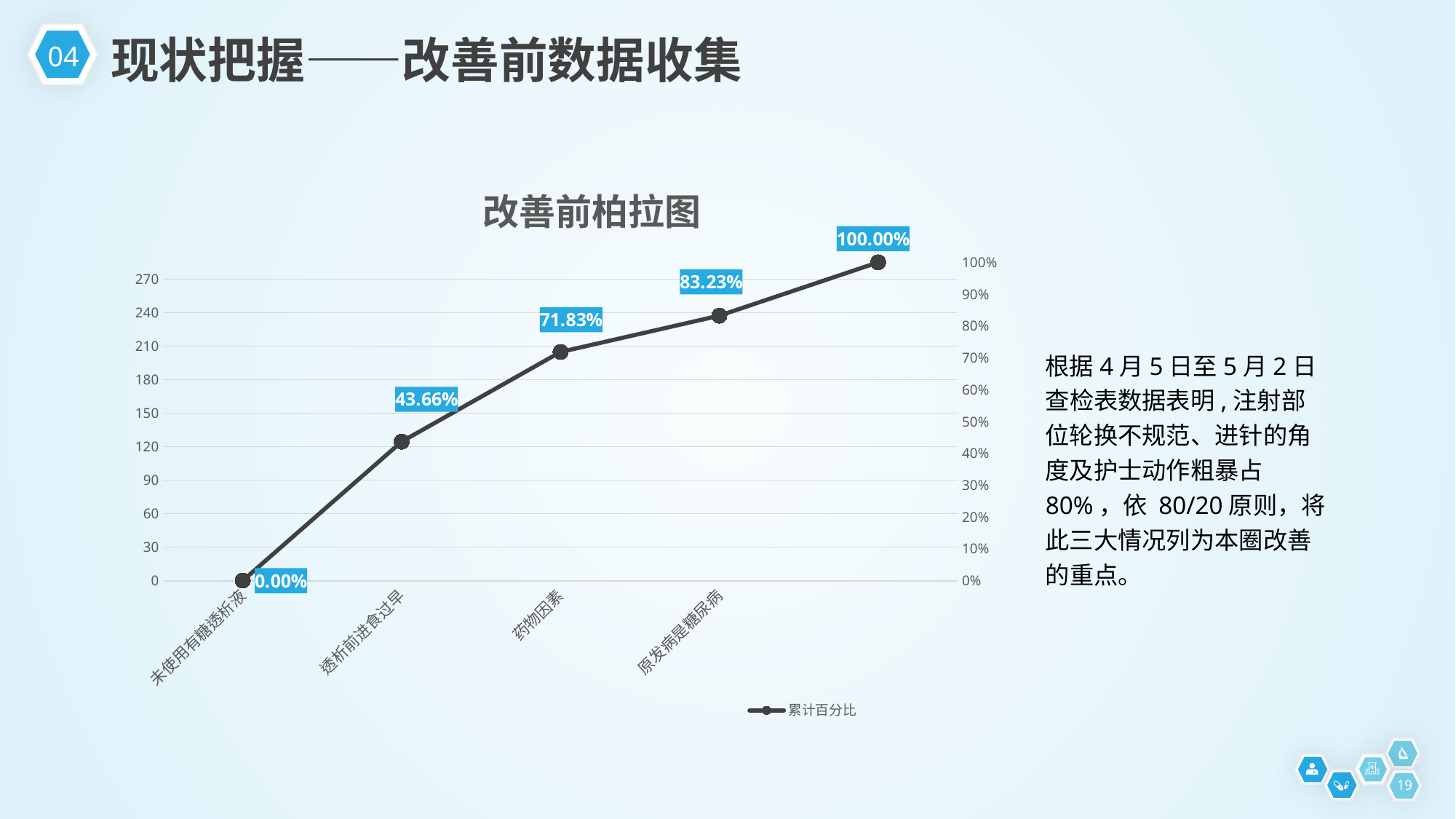
What is the cumulative percentage value for 透析前进食过早? 43.66% Which has a larger cumulative percentage, 原发病是糖尿病 or 药物因素? 原发病是糖尿病 How many series does the chart legend list? 1 What is the cumulative percentage value for 原发病是糖尿病? 83.23% Do the cumulative percentage values rise or fall from left to right along the x axis? rise What is the title of the chart? 改善前柏拉图 What is the cumulative percentage value for 药物因素? 71.83% What is the highest cumulative percentage value labelled on the chart? 100.00% What type of chart is shown on the slide? line chart What is the name of the series shown in the legend? 累计百分比 What is the difference between the cumulative percentage for 药物因素 and for 透析前进食过早? 28.17% What is the cumulative percentage value for 未使用有糖透析液? 0.00%